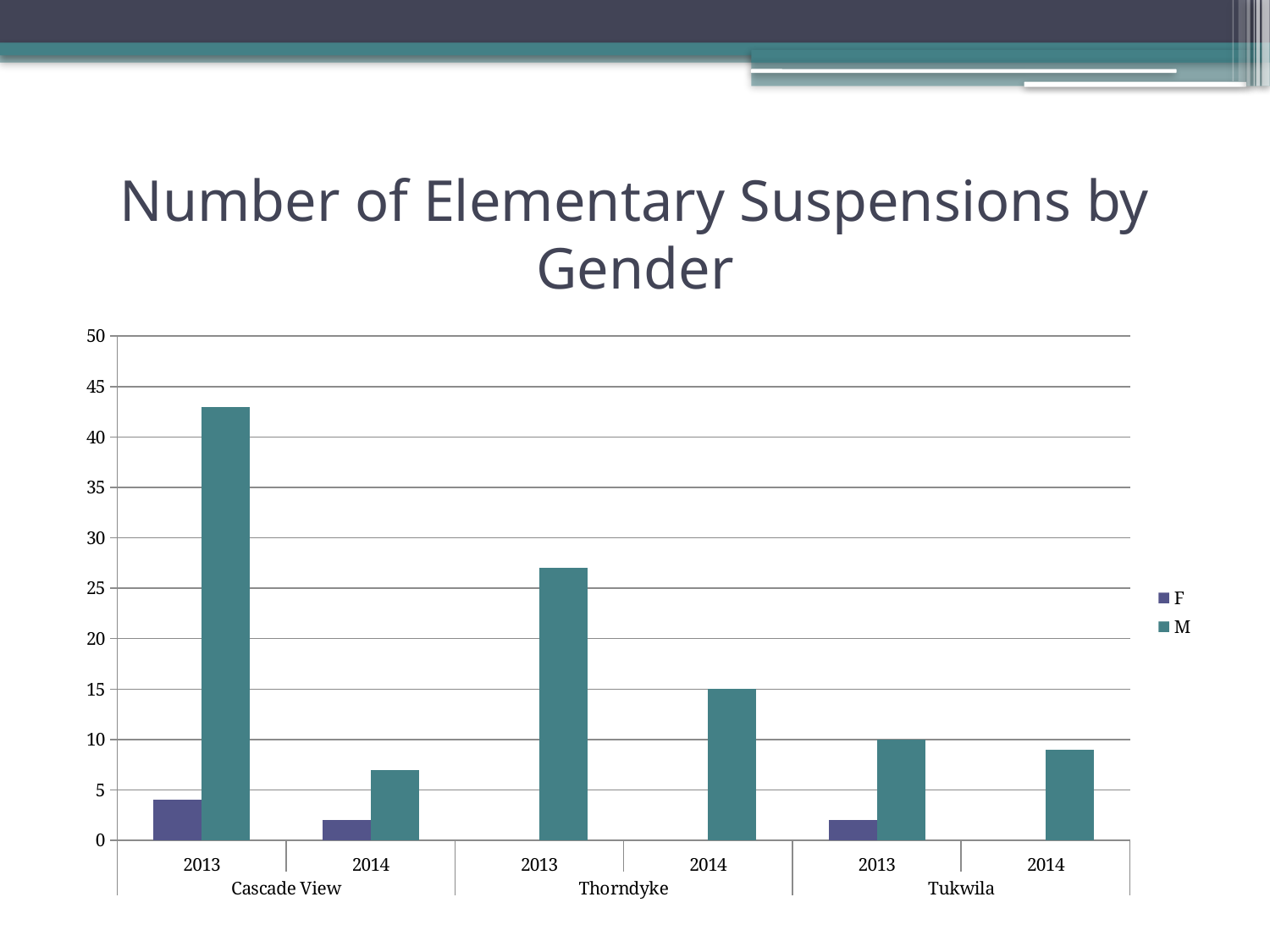
What kind of chart is shown on the slide? bar chart For Cascade View, do the M suspensions rise or fall from 2013 to 2014? fall Is the value for M at Thorndyke in 2013 greater or less than 25? greater What is the value for M at Tukwila in 2013? 10 Which school and year has the highest number of male (M) suspensions? Cascade View, 2013 Is the value for M at Cascade View in 2013 greater or less than 40? greater What are the two series named in the legend? F and M Is the value for F at Cascade View in 2013 greater or less than 5? less How many schools are shown along the x axis? 3 What is the value for M at Thorndyke in 2014? 15 Which is larger, the M value for Thorndyke in 2013 or the M value for Thorndyke in 2014? Thorndyke 2013 How many series does the legend list? 2